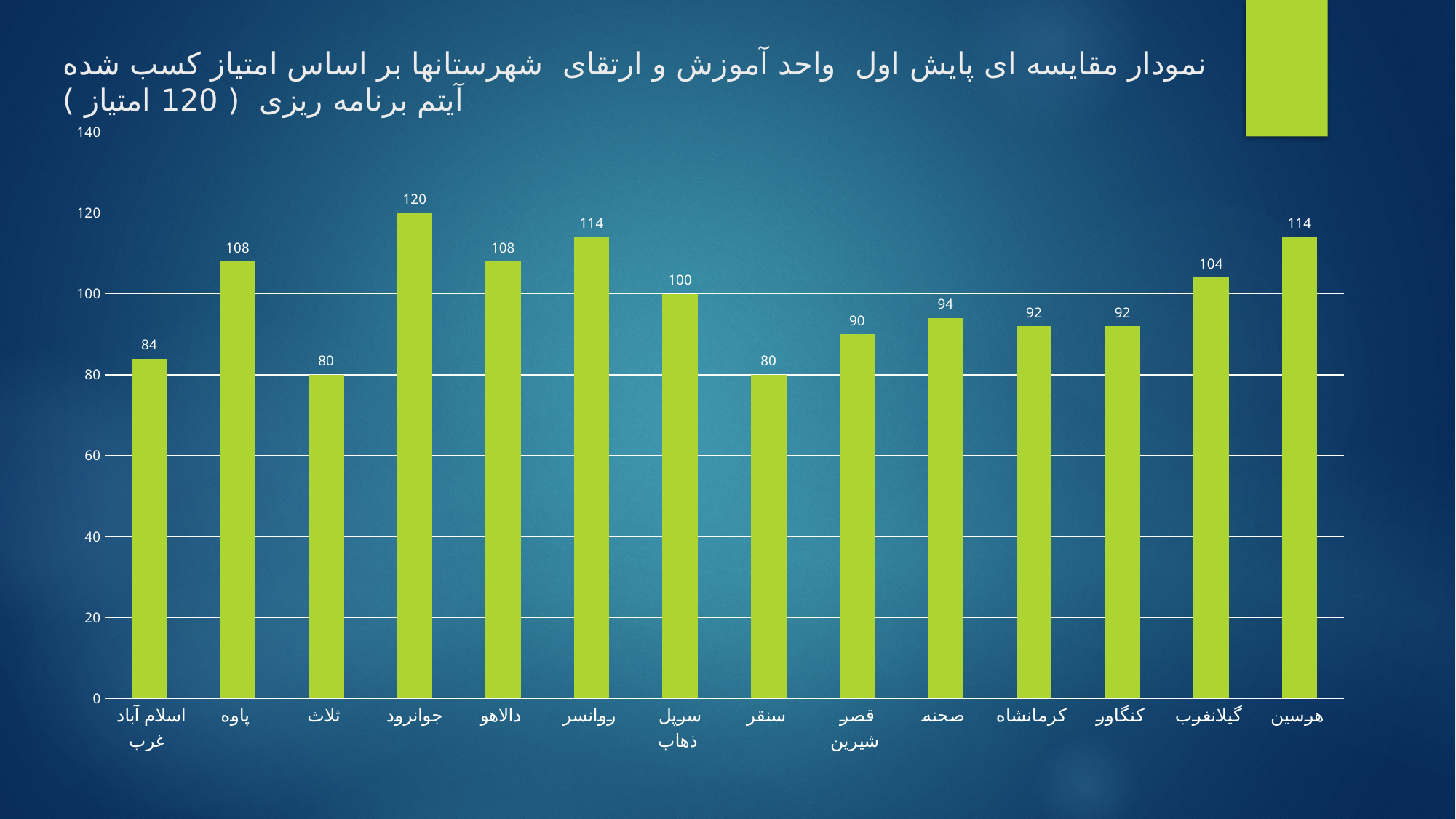
What is the lowest value shown in the chart? 80 What is the difference between the values for روانسر and صحنه? 20 How many categories (cities) are shown on the x axis of the chart? 14 What is the difference between the values for جوانرود and سنقر? 40 Which category has the highest value? جوانرود What colour are the bars in the chart? green What is the value for گیلانغرب? 104 What type of chart is shown on the slide? bar chart What is the value for کرمانشاه? 92 What is the value for اسلام آباد غرب? 84 Which has a larger value, پاوه or قصر شیرین? پاوه What is the value for جوانرود? 120